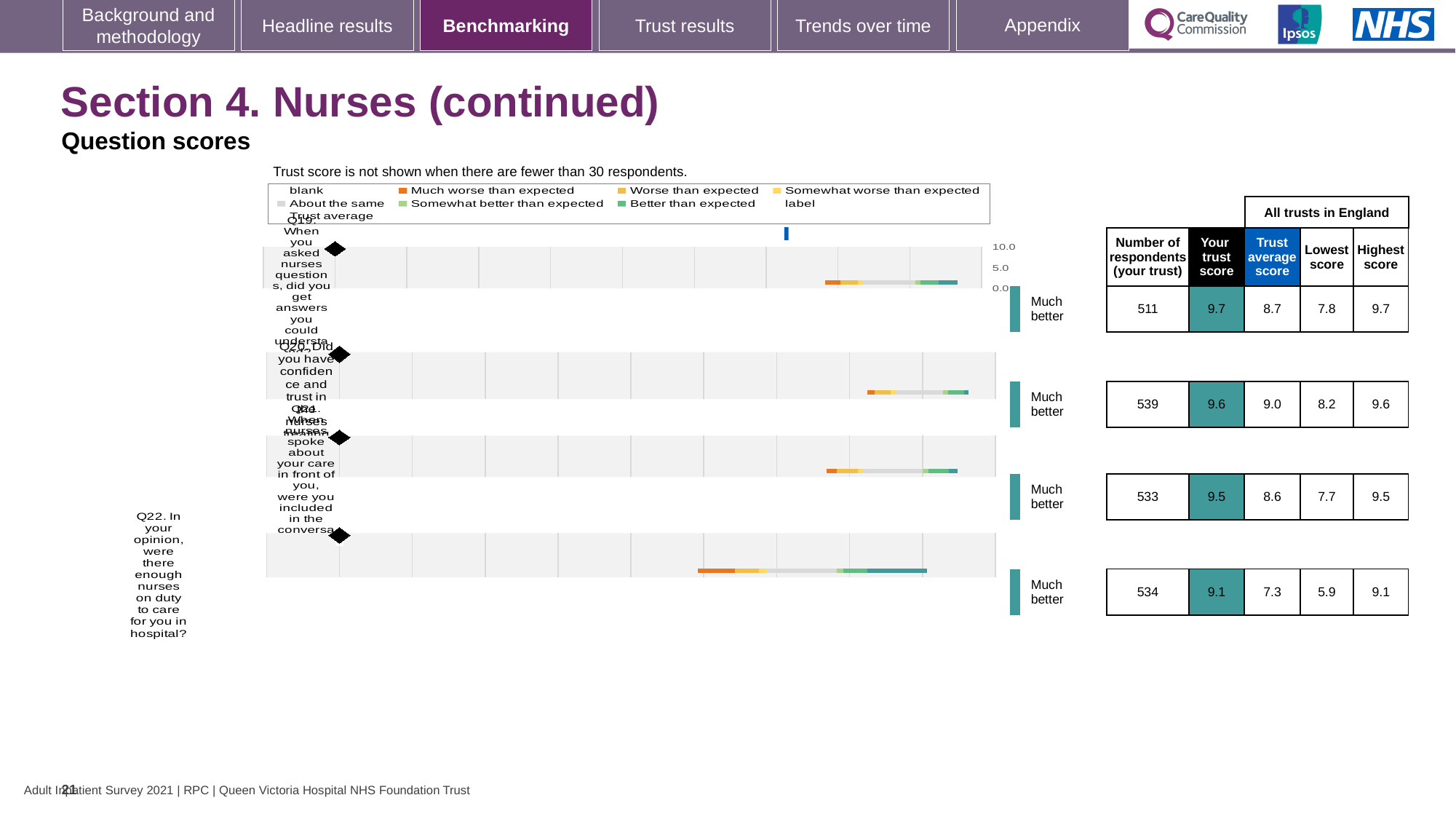
What kind of chart is used to show the question scores? Bar chart What is the trust average score for Q20 (confidence and trust in nurses)? 9.0 What is the 'Your trust score' for Q22 (were there enough nurses on duty to care for you in hospital)? 9.1 For Q22, what is the difference between your trust score and the trust average score? 1.8 How many respondents from your trust answered Q19? 511 What benchmark category label is shown next to each of the four questions? Much better How many questions are shown on this slide? 4 Which has the larger 'Your trust score': Q19 or Q21? Q19 Which question has the lowest 'Your trust score' on this slide? Q22 What is the highest score across all trusts in England for Q22? 9.1 What is the lowest score across all trusts in England for Q21? 7.7 Which question has the highest 'Your trust score' on this slide? Q19